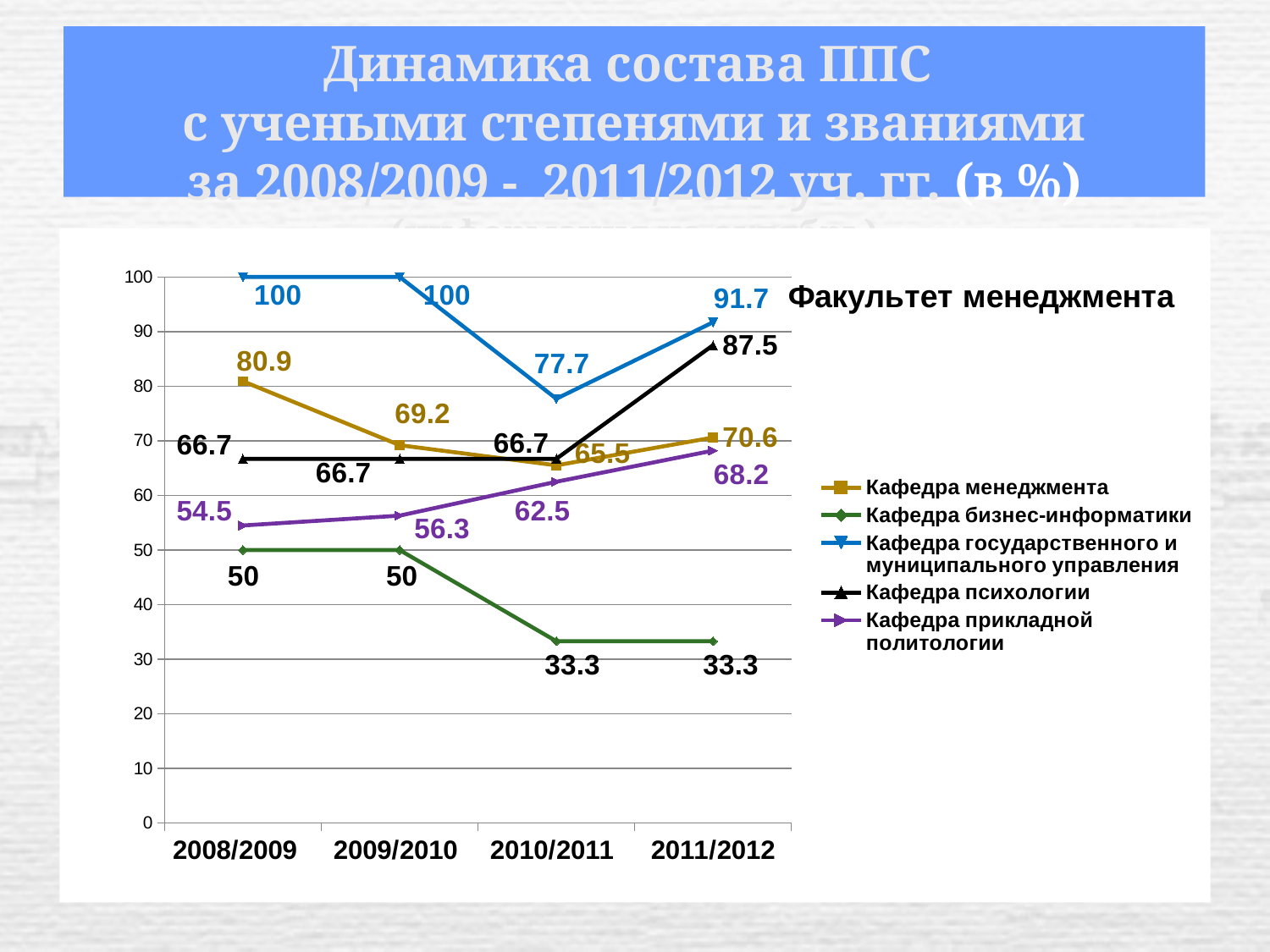
By how much did the value for Кафедра бизнес-информатики fall from 2009/2010 to 2010/2011? 16.7 Does the value for Кафедра прикладной политологии rise or fall from 2008/2009 to 2011/2012? Rises What kind of chart is shown on the slide? Line chart How many series does the legend list? 5 Which department has the highest value in 2008/2009? Кафедра государственного и муниципального управления Which faculty is named in the label at the top right of the chart? Факультет менеджмента What is the value for Кафедра менеджмента in 2008/2009? 80.9 What is the value for Кафедра психологии in 2011/2012? 87.5 What is the value for Кафедра государственного и муниципального управления in 2010/2011? 77.7 How many academic years are shown on the x axis? 4 In 2011/2012, which is larger: the value for Кафедра менеджмента or for Кафедра прикладной политологии? Кафедра менеджмента Which department has the lowest value in 2011/2012? Кафедра бизнес-информатики